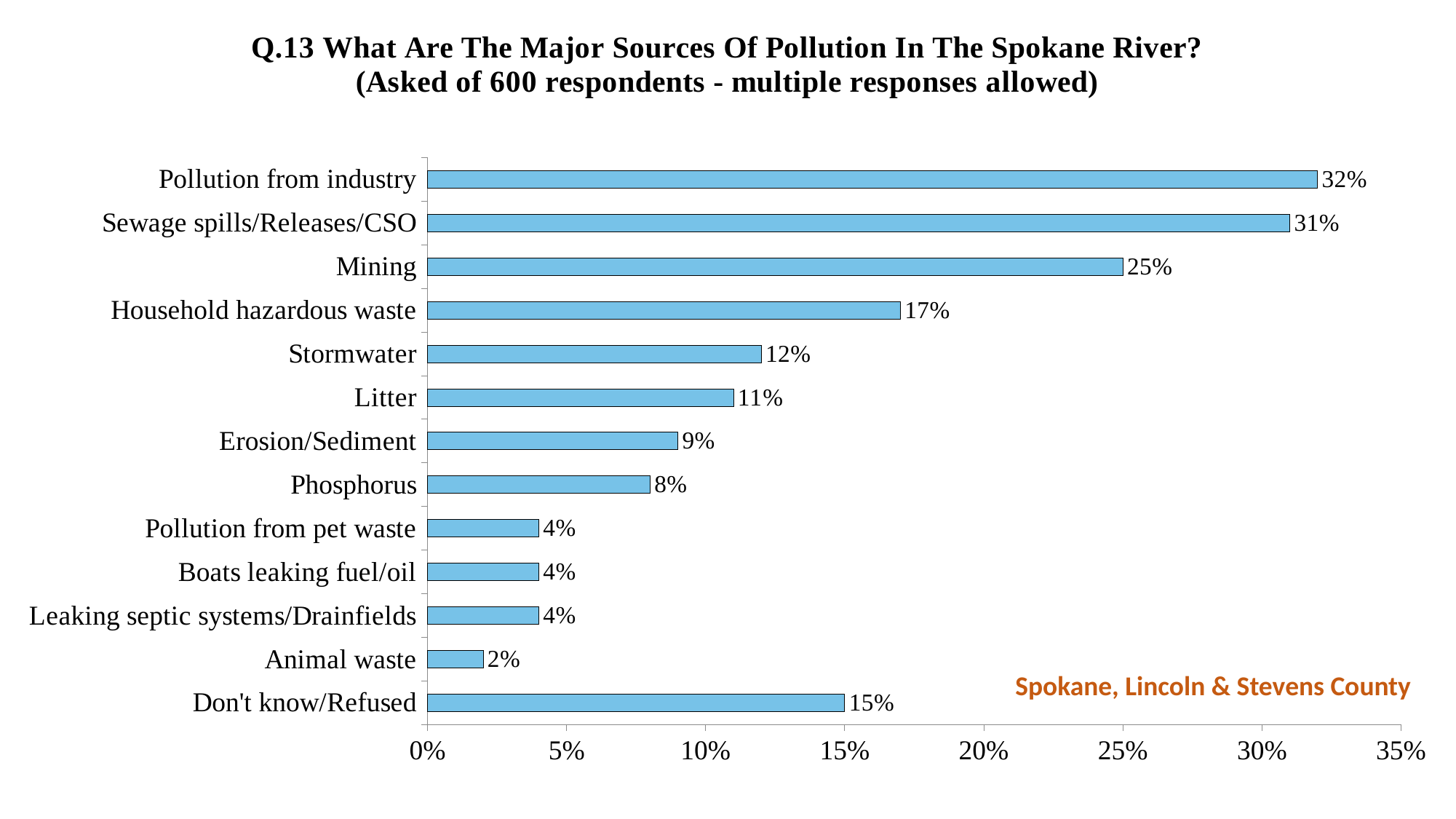
Which source of pollution has the highest percentage on the chart? Pollution from industry How many respondents were asked the question, according to the chart title? 600 Is the value for Mining greater or less than 20%? greater Which category has the lowest percentage on the chart? Animal waste Which is larger, the value for Litter or the value for Erosion/Sediment? Litter What percentage of respondents named Mining as a major source of pollution in the Spokane River? 25% What kind of chart is shown on the slide? Bar chart What is the value shown for Stormwater? 12% What percentage is shown for Don't know/Refused? 15% How many categories are shown on the chart? 13 What is the difference between Household hazardous waste and Phosphorus? 9% What is the difference in percentage points between Pollution from industry and Sewage spills/Releases/CSO? 1%